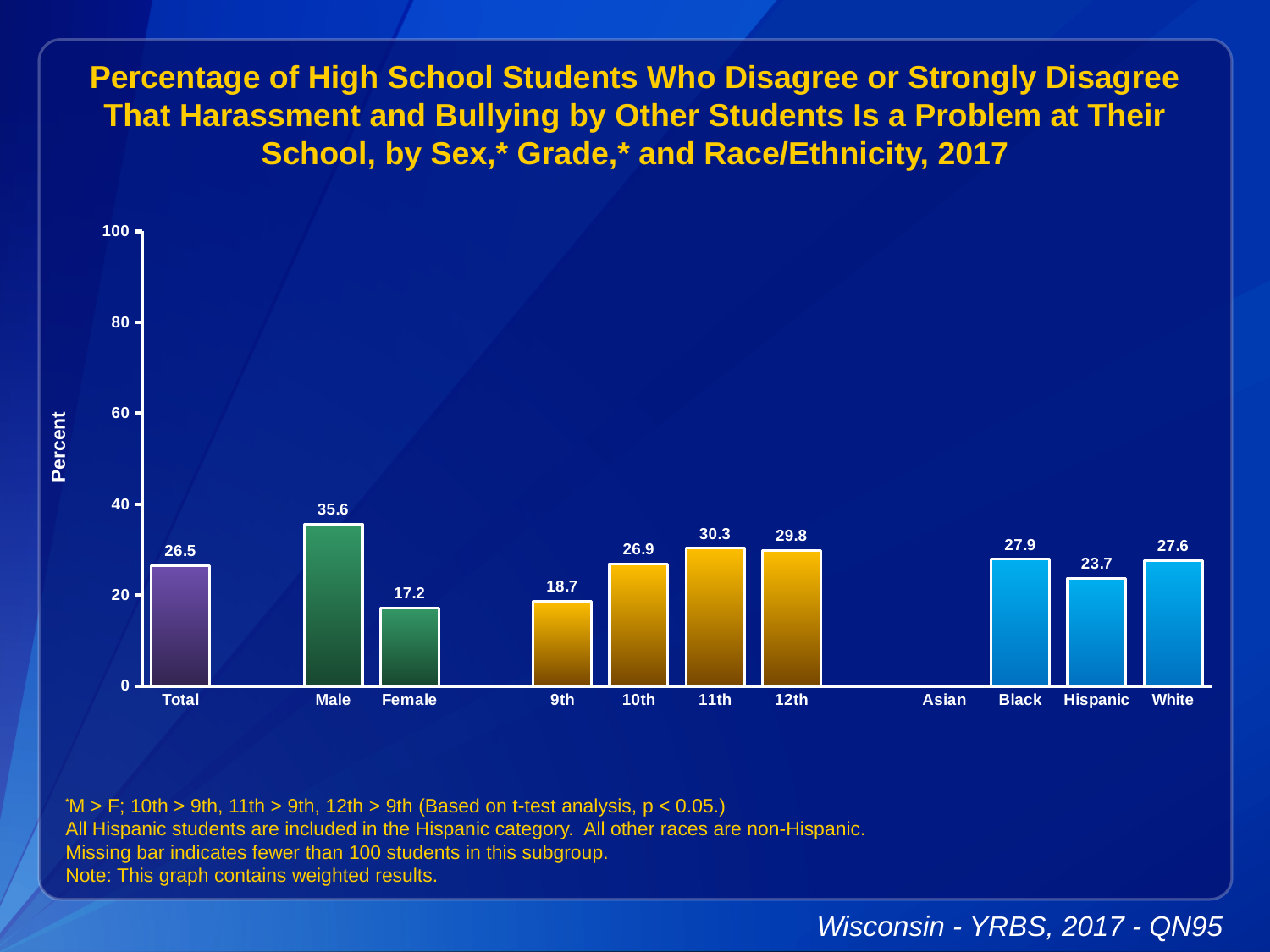
How many categories have a bar plotted? 10 Which category on the x axis has no bar? Asian What is the value for Hispanic? 23.7 Which category has the lowest value among those with a bar? Female Which category has the highest value? Male What is the value for 9th grade? 18.7 Which is larger, the value for 11th grade or 12th grade? 11th What is the value for Male? 35.6 Is the value for Total greater or less than 40? less What is the value for Female? 17.2 What kind of chart is shown? bar chart What is the difference between the Male and Female values? 18.4